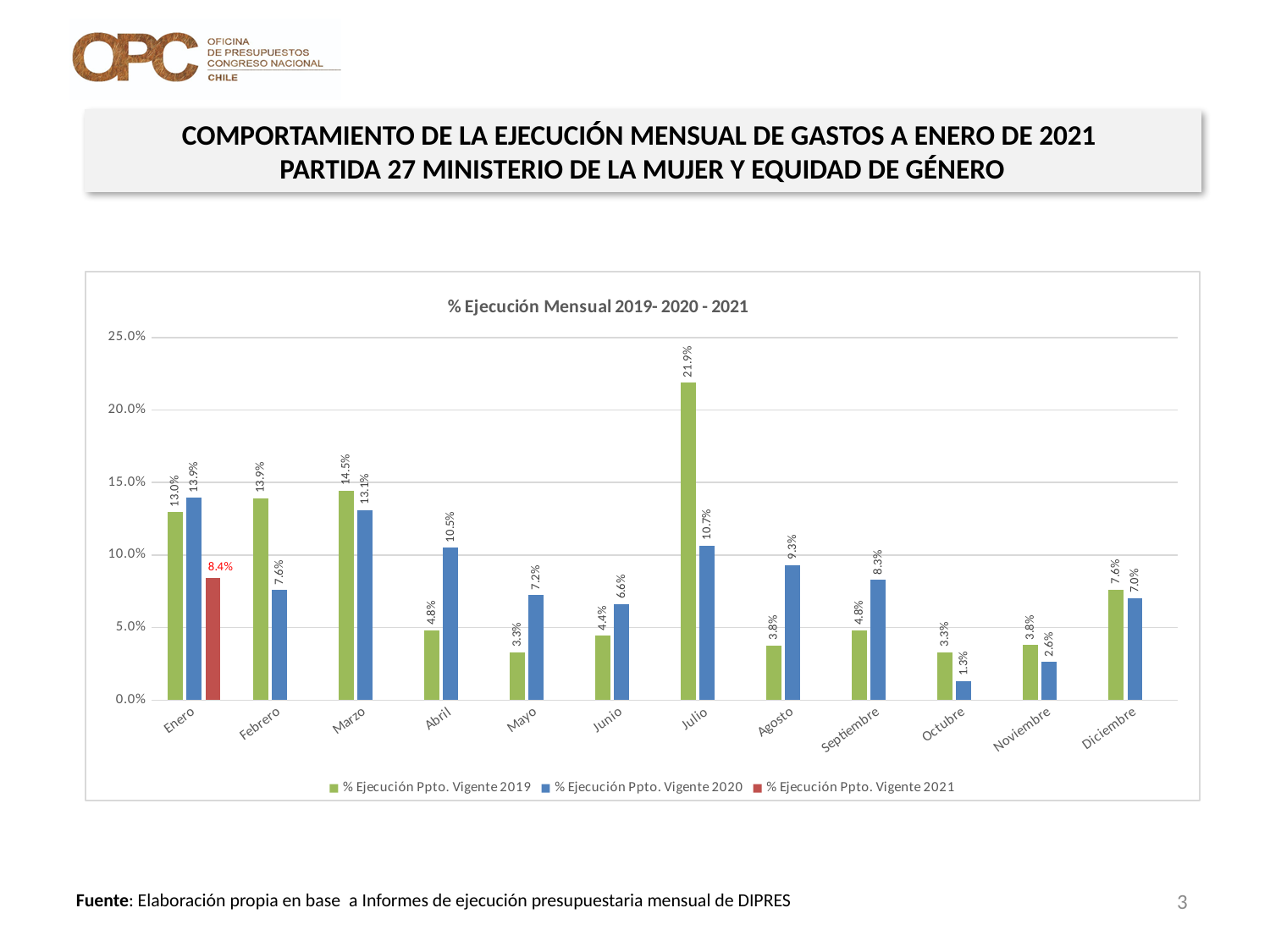
How many months are shown on the x axis? 12 What is the difference between the 2019 and 2020 values in Julio? 11.2% Which month has the highest value for % Ejecución Ppto. Vigente 2019? Julio Which is larger in Agosto: the 2019 value or the 2020 value? 2020 (9.3%) What is the value for % Ejecución Ppto. Vigente 2020 in Abril? 10.5% How many series does the legend list? 3 What colour are the bars for % Ejecución Ppto. Vigente 2020? Blue What kind of chart is shown on the slide? Bar chart Which month has the lowest value for % Ejecución Ppto. Vigente 2020? Octubre What is the value for % Ejecución Ppto. Vigente 2021 in Enero? 8.4% What is the value for % Ejecución Ppto. Vigente 2019 in Julio? 21.9% What is the title of the chart? % Ejecución Mensual 2019- 2020 - 2021